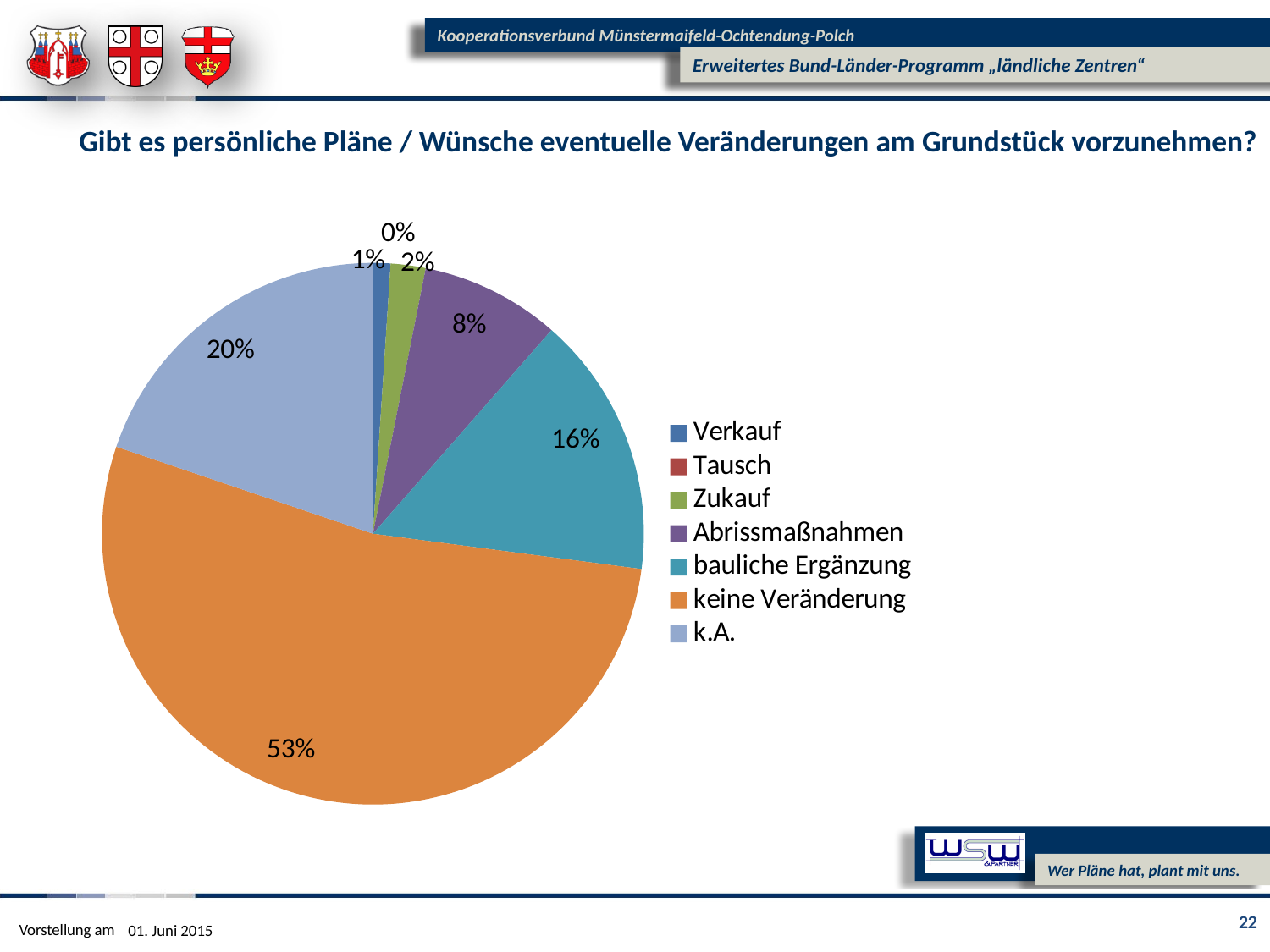
What share of the pie does "Abrissmaßnahmen" have? 8% What share of the pie does "keine Veränderung" have? 53% Which has a larger share: "k.A." or "bauliche Ergänzung"? k.A. What share of the pie does "bauliche Ergänzung" have? 16% What is the difference in percentage points between "keine Veränderung" and "k.A."? 33% Which category has the smallest share of the pie? Tausch How many categories does the legend list? 7 What kind of chart is shown on the slide? pie chart Which category has the largest share of the pie? keine Veränderung